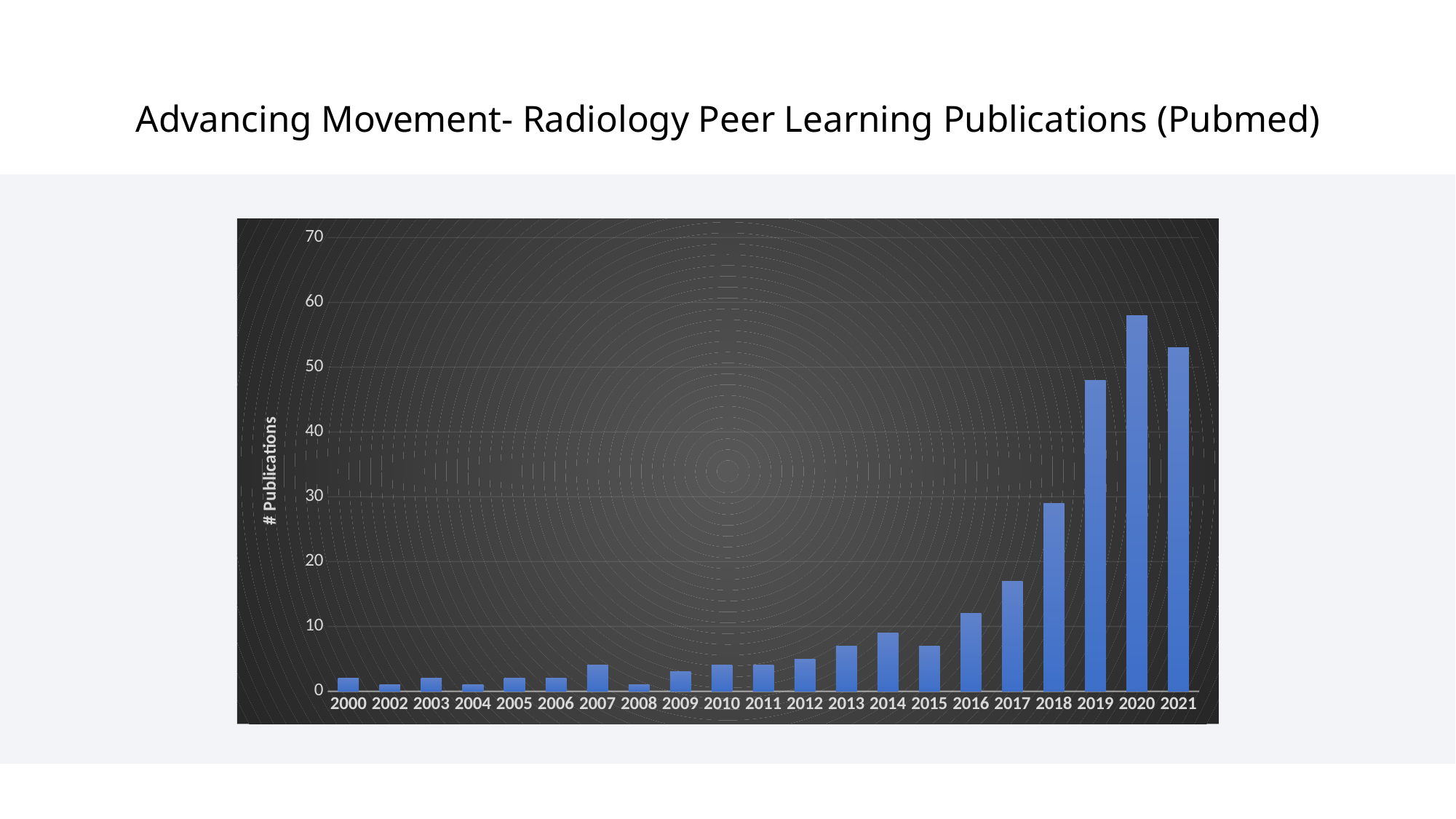
Which year has more publications, 2020 or 2021? 2020 Which year has the highest number of publications? 2020 What is the label on the vertical axis of the chart? # Publications Is the value for 2016 greater or less than 10? greater Is the value for 2013 greater or less than 10? less Is the value for 2019 greater or less than 40? greater How many years are shown on the x axis of the chart? 21 Do the number of publications generally rise or fall from 2000 to 2020? rise What kind of chart is shown on the slide? bar chart Which year has more publications, 2018 or 2019? 2019